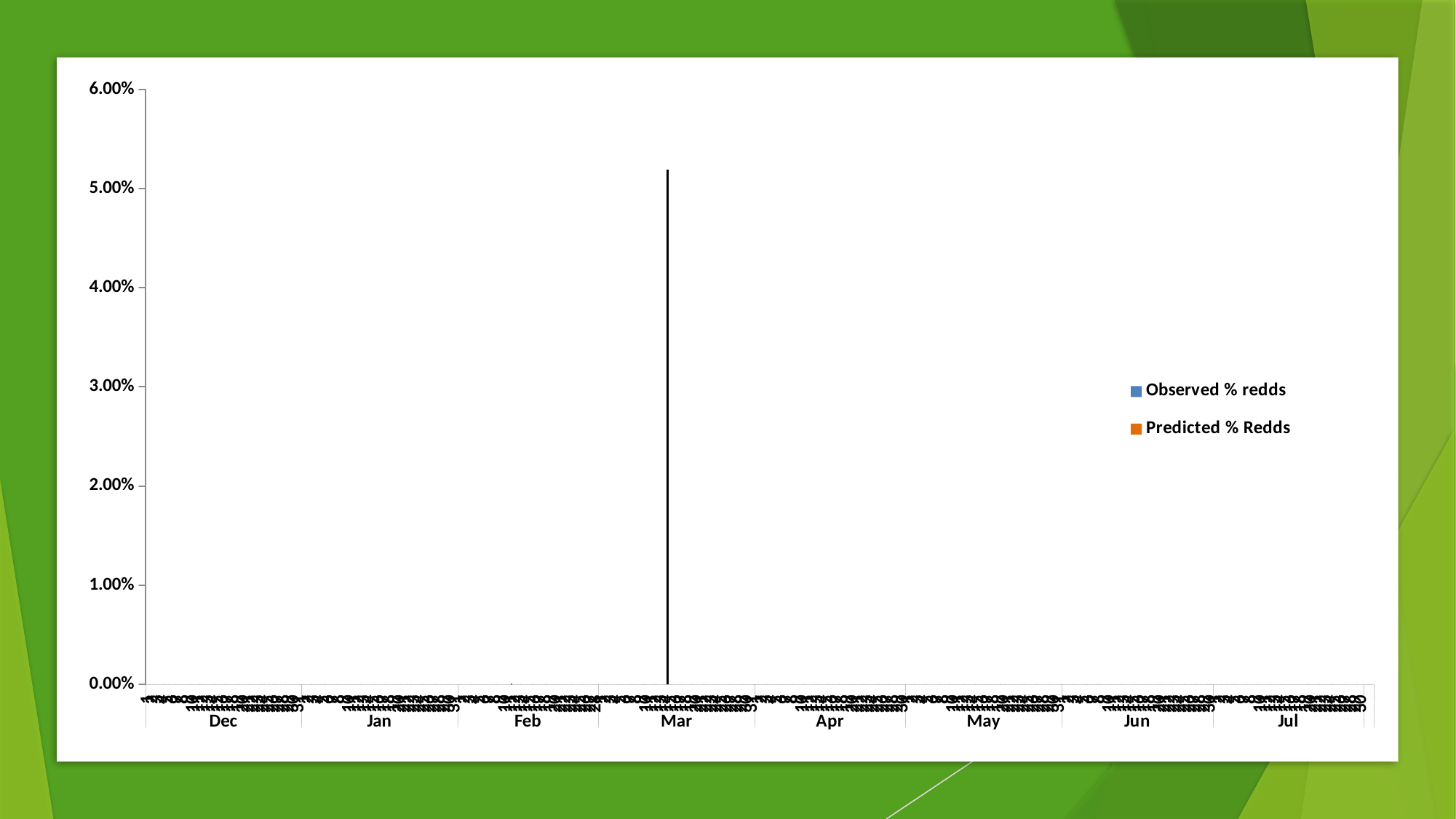
Is the tall spike in Mar greater or less than 5.00%? greater What is the first month label on the x axis? Dec In which month does the chart show its single tall spike? Mar Is the tall spike in Mar greater or less than 6.00%? less What are the two series named in the legend? Observed % redds and Predicted % Redds What is the last month label on the x axis? Jul How many series does the legend list? 2 What is the highest value shown on the y axis? 6.00% How many month labels are shown along the x axis? 8 Which colour is used for the Predicted % Redds series in the legend? Orange What is the lowest value shown on the y axis? 0.00%